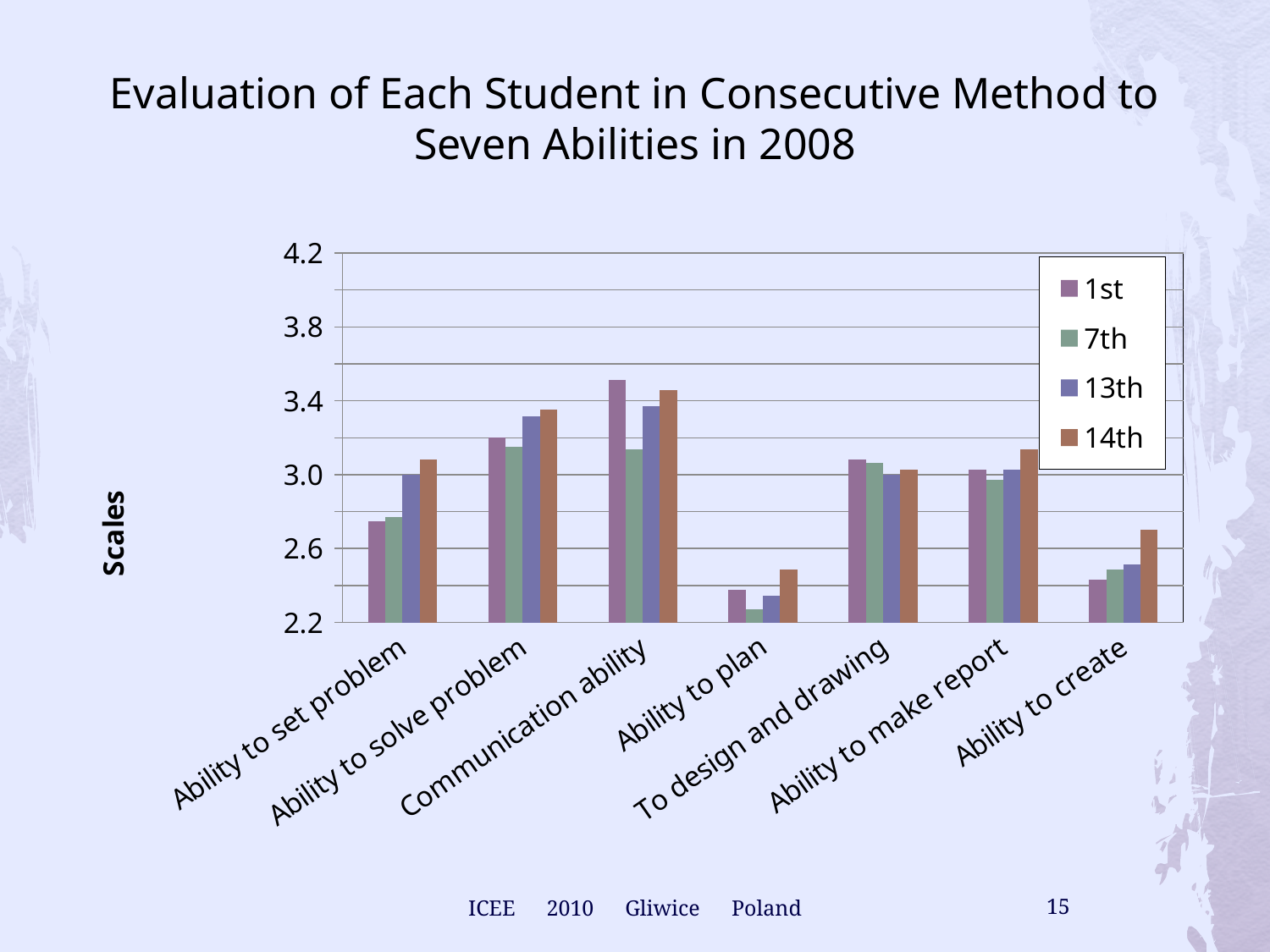
Which ability has the lowest value for the 7th series? Ability to plan For Communication ability, which is larger: the 1st series value or the 7th series value? 1st What type of chart is shown on the slide? Bar chart How many series does the legend list? 4 Is the 7th series value for Ability to plan greater or less than 2.6? less What is the label on the vertical axis of the chart? Scales Is the 1st series value for Communication ability greater or less than 3.4? greater For Ability to solve problem, which is larger: the 14th series value or the 7th series value? 14th Which ability has the highest value for the 1st series? Communication ability Is the 14th series value for Ability to create greater or less than 3.0? less How many ability categories are shown along the x axis? 7 Which ability has the lowest value for the 14th series? Ability to plan